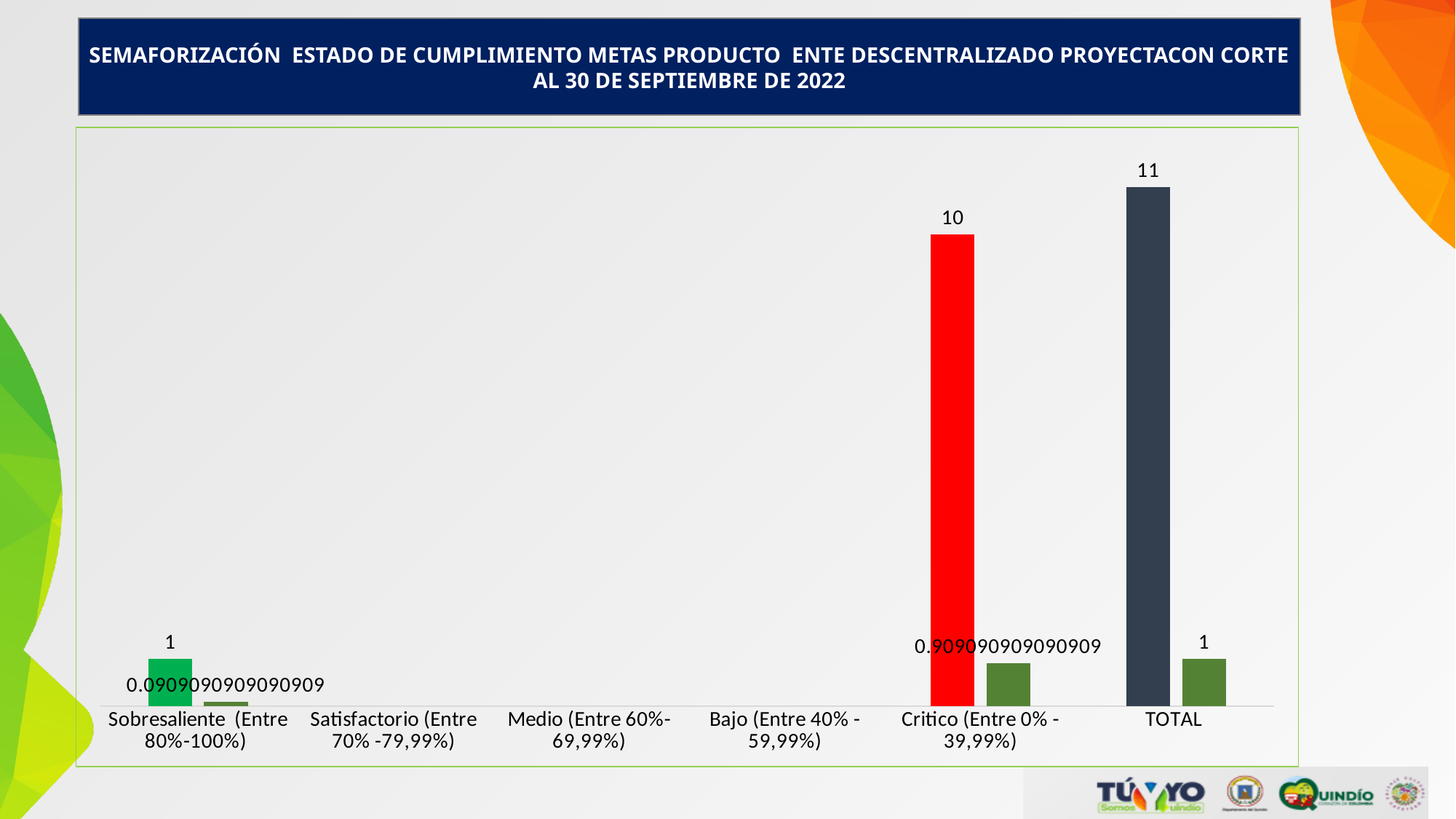
Which has a larger count, Critico (Entre 0% - 39,99%) or Sobresaliente (Entre 80%-100%)? Critico (Entre 0% - 39,99%) What is the smaller (proportion) value labelled for the Critico (Entre 0% - 39,99%) category? 0.909090909090909 What is the count value shown for the Critico (Entre 0% - 39,99%) category? 10 Excluding TOTAL, which category has the highest count? Critico (Entre 0% - 39,99%) What colour is the tall bar for the Critico (Entre 0% - 39,99%) category? Red What is the count value shown for the TOTAL category? 11 What is the difference between the count for Critico (Entre 0% - 39,99%) and the count for Sobresaliente (Entre 80%-100%)? 9 How many categories are shown on the x axis of the chart? 6 What is the smaller (proportion) value labelled for the Sobresaliente (Entre 80%-100%) category? 0.0909090909090909 What kind of chart is shown on the slide? Bar chart What is the count value shown for the Sobresaliente (Entre 80%-100%) category? 1 Which category has the tallest bar in the chart? TOTAL